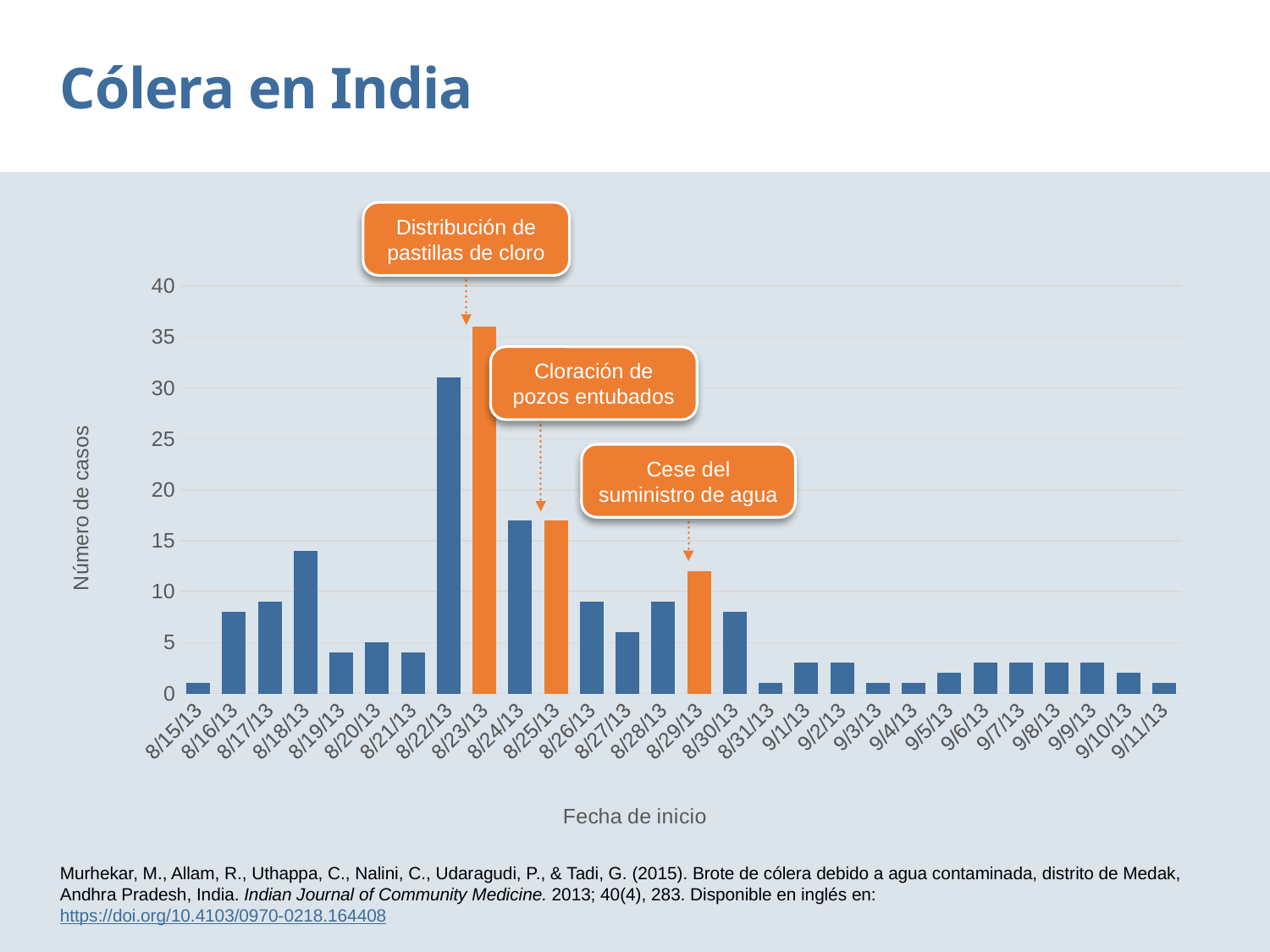
What kind of chart is shown on the slide? bar chart What is the title of the x axis? Fecha de inicio Is the value for 8/29/13 greater or less than 10? greater Is the value for 8/18/13 greater or less than 10? greater Which date has the highest number of cases? 8/23/13 Is the value for 8/22/13 greater or less than 25? greater Do the values generally rise or fall from 8/23/13 to 8/31/13? fall Which has more cases, 8/18/13 or 8/19/13? 8/18/13 How many dates are shown on the x axis? 28 Which has more cases, 8/22/13 or 8/24/13? 8/22/13